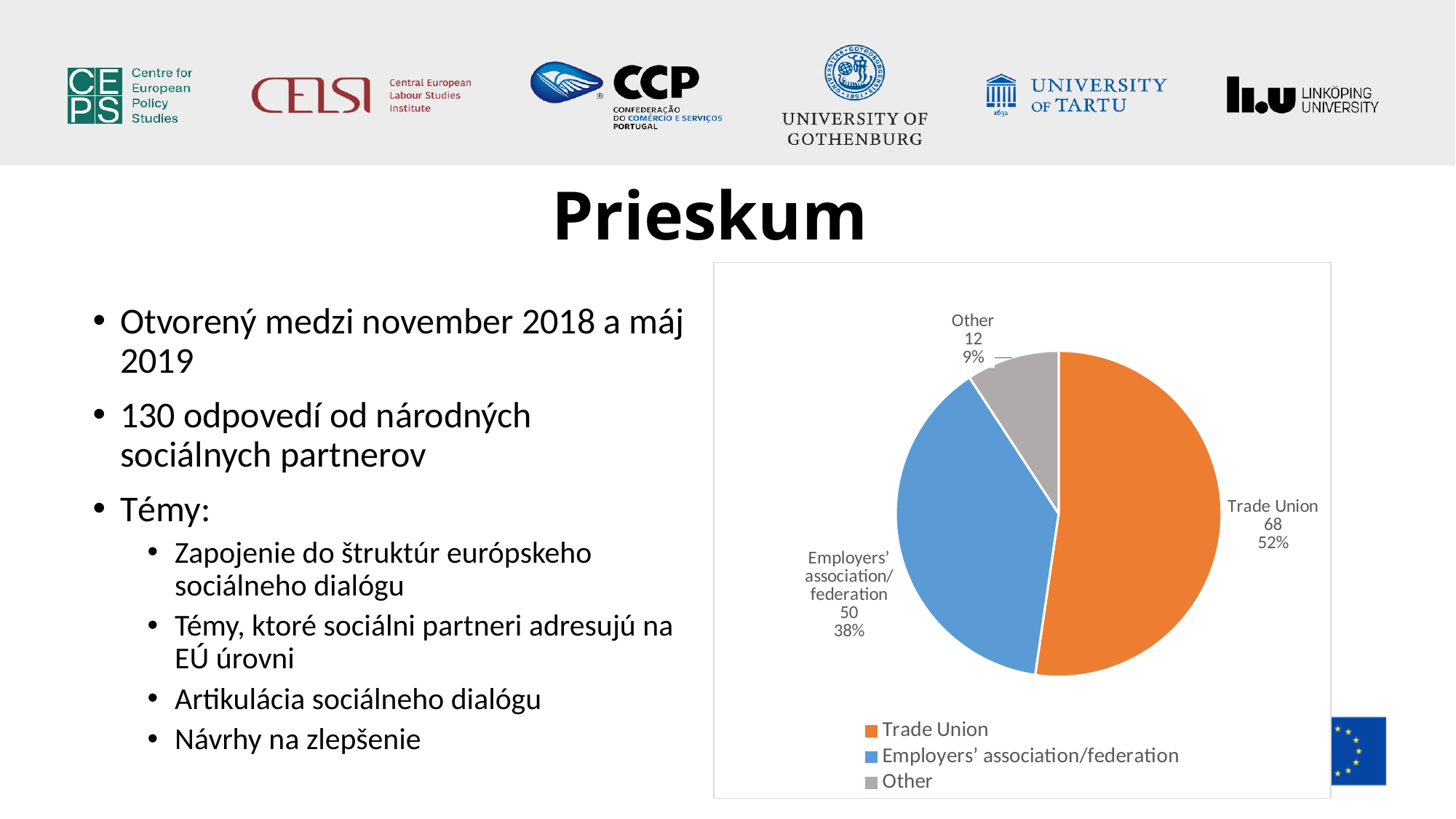
What is the difference between the values for Trade Union and Employers' association/federation? 18 How many entries does the legend of the pie chart list? 3 What kind of chart is shown on the slide? pie chart Which colour is used for the Employers' association/federation slice? blue What share of the pie does Other represent? 9% What is the value for Trade Union in the pie chart? 68 What share of the pie does Trade Union represent? 52% How many slices does the pie chart have? 3 What is the value for Other in the pie chart? 12 What is the value for Employers' association/federation in the pie chart? 50 Which category has the largest slice in the pie chart? Trade Union Which category has the smallest slice in the pie chart? Other